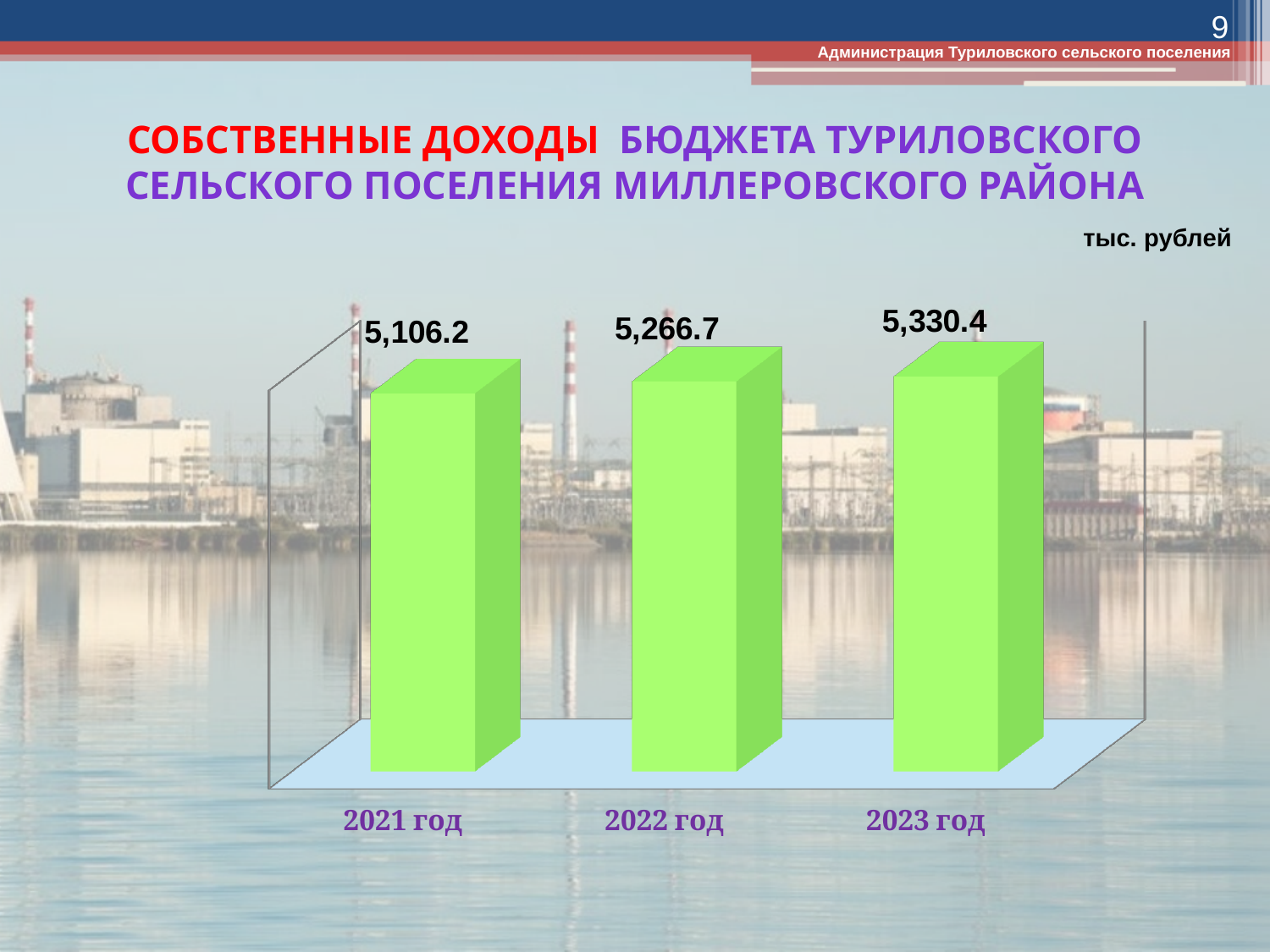
Which is larger, the value for 2021 год or the value for 2023 год? 2023 год What is the difference between the values for 2023 год and 2021 год? 224.2 What is the value for 2022 год? 5,266.7 What is the difference between the values for 2022 год and 2021 год? 160.5 What is the difference between the values for 2023 год and 2022 год? 63.7 What is the value for 2023 год? 5,330.4 What is the value for 2021 год? 5,106.2 Which year has the lowest value? 2021 год Do the values rise or fall from 2021 год to 2023 год? rise Which year has the highest value? 2023 год What kind of chart is shown on the slide? bar chart How many bars are shown in the chart? 3